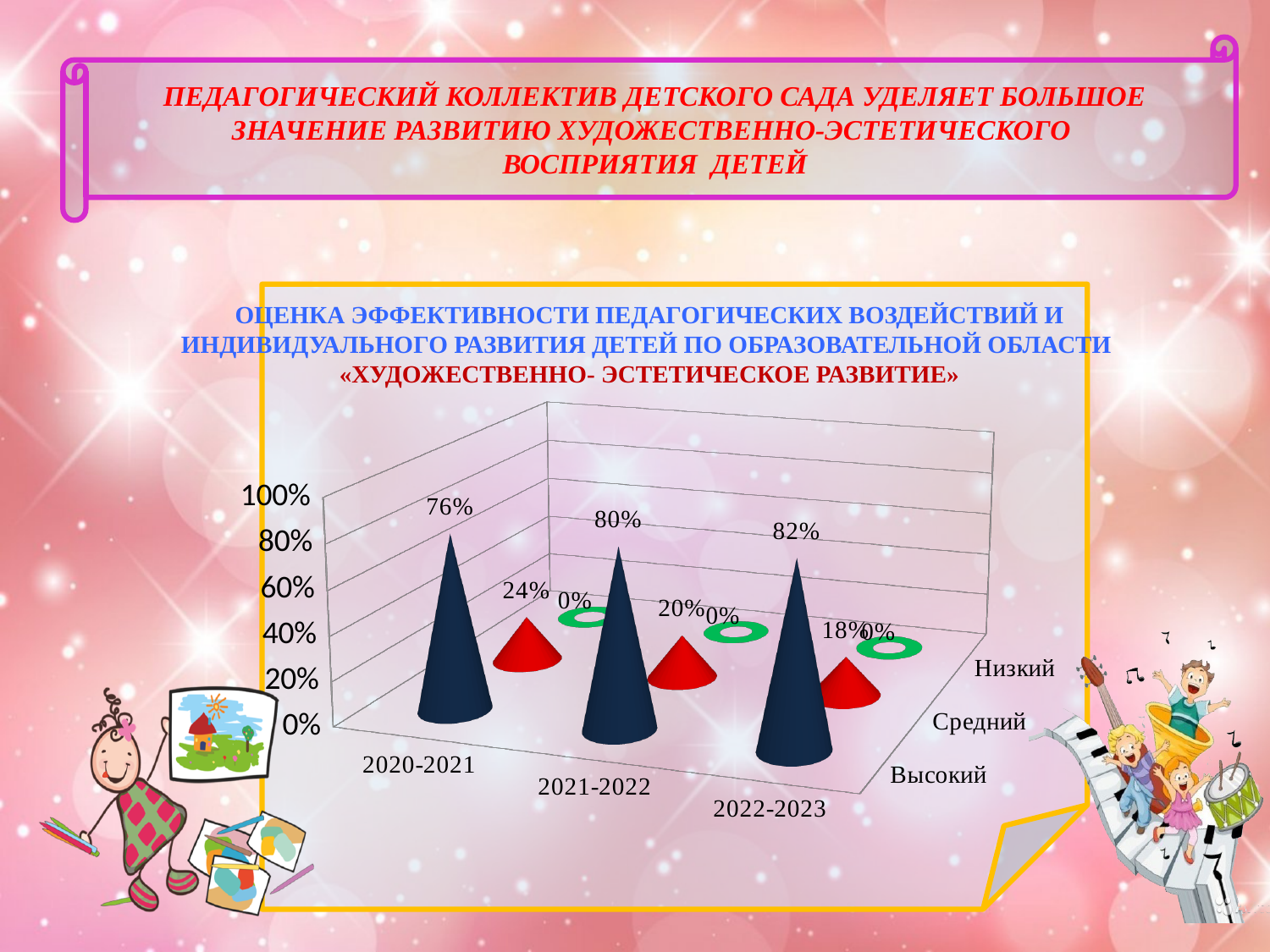
Does the Высокий value rise or fall from 2020-2021 to 2022-2023? rise What are the names of the three series in the chart? Высокий, Средний, Низкий How many series does the chart show? 3 How many periods are shown on the x axis? 3 In which period is the Средний value the lowest? 2022-2023 What is the value for Высокий in 2022-2023? 82% What is the difference between the Высокий values for 2022-2023 and 2020-2021? 6% What is the value for Высокий in 2021-2022? 80% In which period is the Высокий value the highest? 2022-2023 What is the value for Низкий in 2021-2022? 0% What is the value for Средний in 2020-2021? 24% Which is larger: the Средний value for 2020-2021 or for 2021-2022? 2020-2021